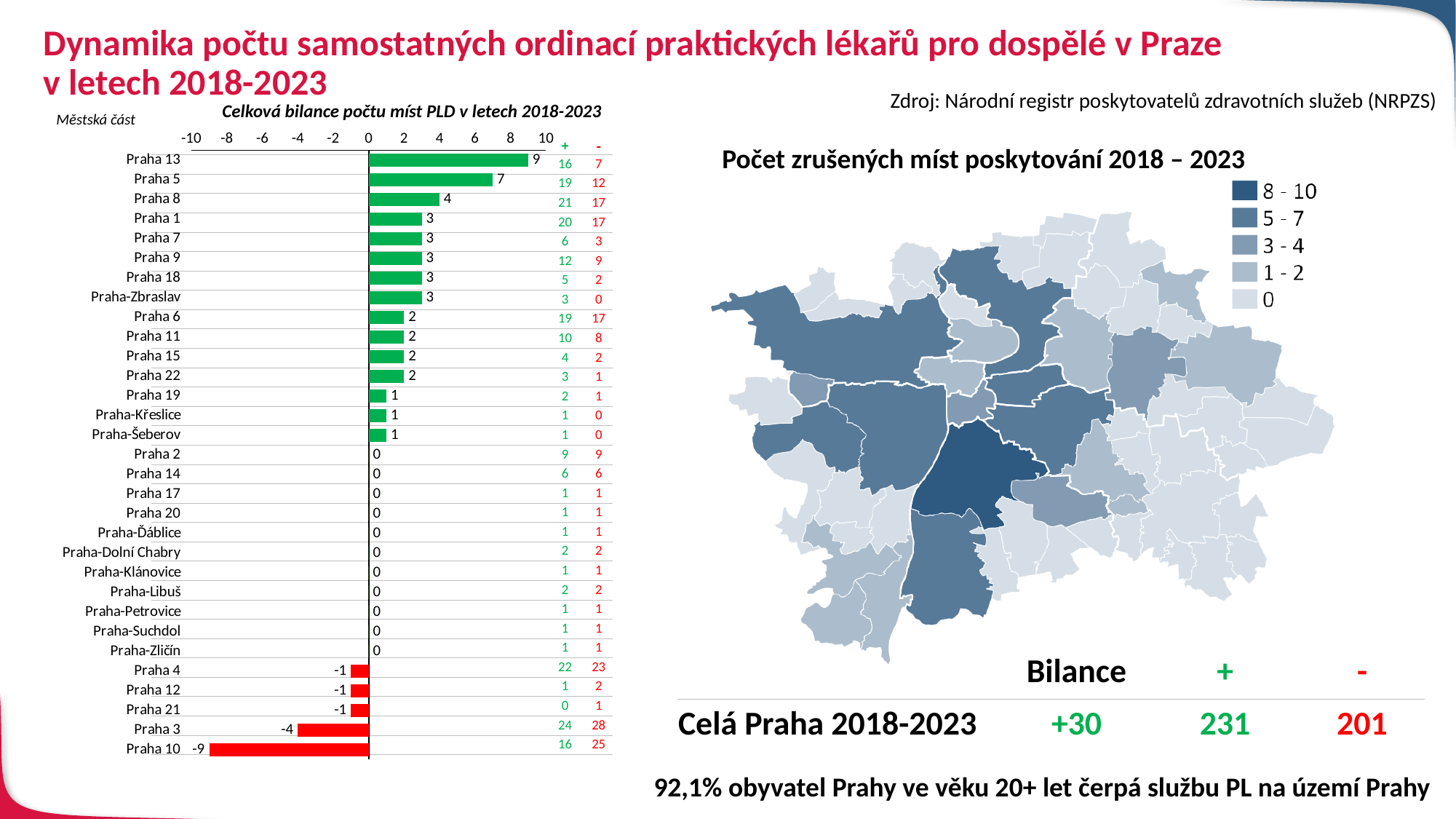
In the bar chart 'Celková bilance počtu míst PLD v letech 2018-2023', which is larger, the value for Praha 5 or the value for Praha 8? Praha 5 In the bar chart 'Celková bilance počtu míst PLD v letech 2018-2023', what is the difference between the values for Praha 13 and Praha 5? 2 In the bar chart 'Celková bilance počtu míst PLD v letech 2018-2023', how many city districts are listed? 31 In the bar chart 'Celková bilance počtu míst PLD v letech 2018-2023', what colour are the bars with negative values? Red In the bar chart 'Celková bilance počtu míst PLD v letech 2018-2023', which city district has the lowest value? Praha 10 In the bar chart 'Celková bilance počtu míst PLD v letech 2018-2023', which city district has the highest value? Praha 13 In the bar chart 'Celková bilance počtu míst PLD v letech 2018-2023', what is the value for Praha 13? 9 In the bar chart 'Celková bilance počtu míst PLD v letech 2018-2023', what is the value for Praha 3? -4 In the bar chart 'Celková bilance počtu míst PLD v letech 2018-2023', what is the value for Praha 4? -1 In the bar chart 'Celková bilance počtu míst PLD v letech 2018-2023', what is the value for Praha 8? 4 In the bar chart 'Celková bilance počtu míst PLD v letech 2018-2023', what is the value for Praha 10? -9 What kind of chart is 'Celková bilance počtu míst PLD v letech 2018-2023'? Bar chart